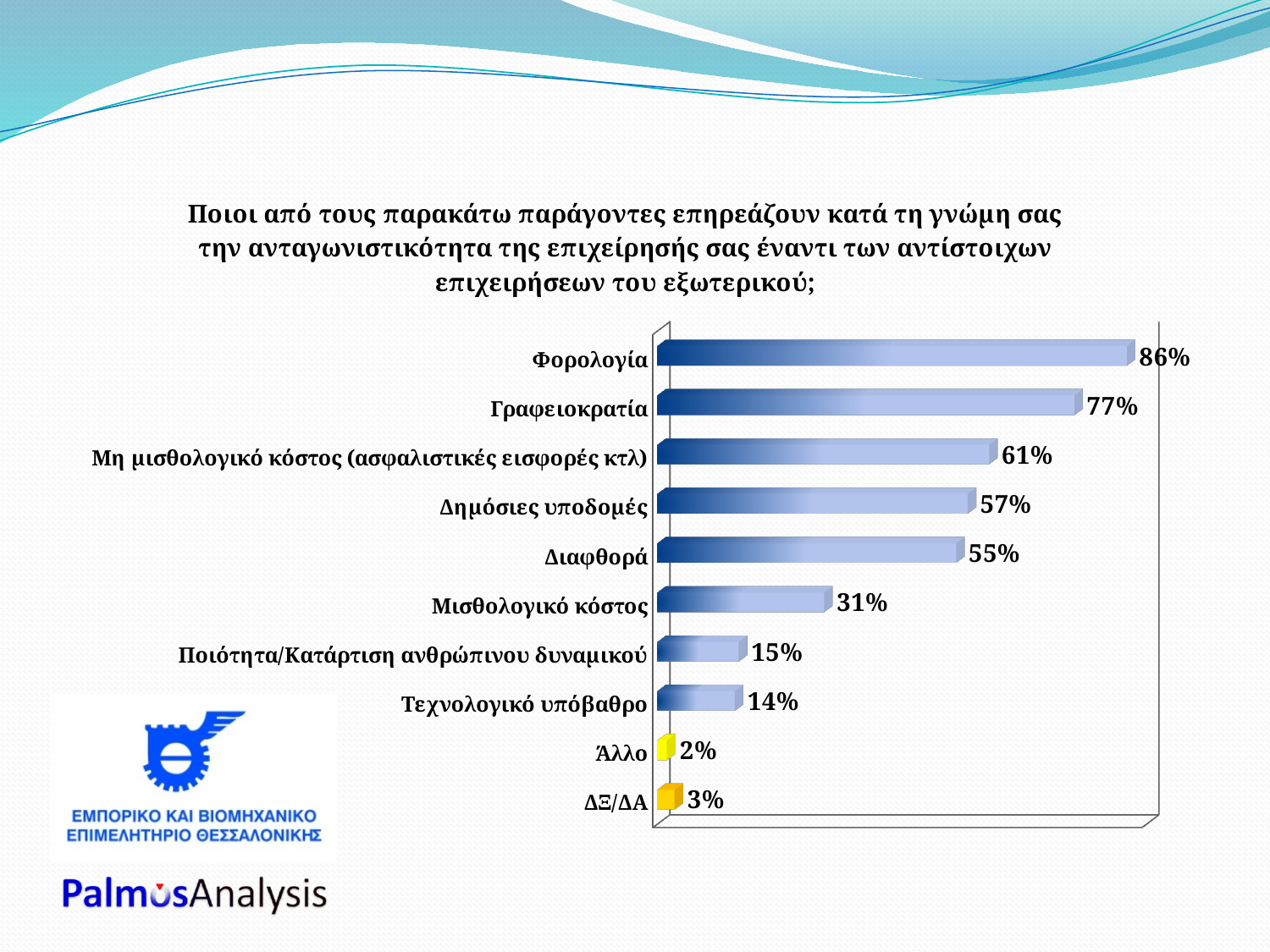
Which category has the lowest value? Άλλο What is the value for Διαφθορά? 55% Which is larger, the value for Άλλο or the value for ΔΞ/ΔΑ? ΔΞ/ΔΑ What is the difference between the values for Φορολογία and Γραφειοκρατία? 9% What is the value for Τεχνολογικό υπόβαθρο? 14% What is the value for Φορολογία? 86% What is the difference between the values for Μη μισθολογικό κόστος (ασφαλιστικές εισφορές κτλ) and Μισθολογικό κόστος? 30% Which is larger, the value for Δημόσιες υποδομές or the value for Διαφθορά? Δημόσιες υποδομές Which category has the highest value? Φορολογία How many categories are shown in the chart? 10 What kind of chart is shown on the slide? Bar chart Which two categories are shown with yellow bars instead of blue? Άλλο and ΔΞ/ΔΑ